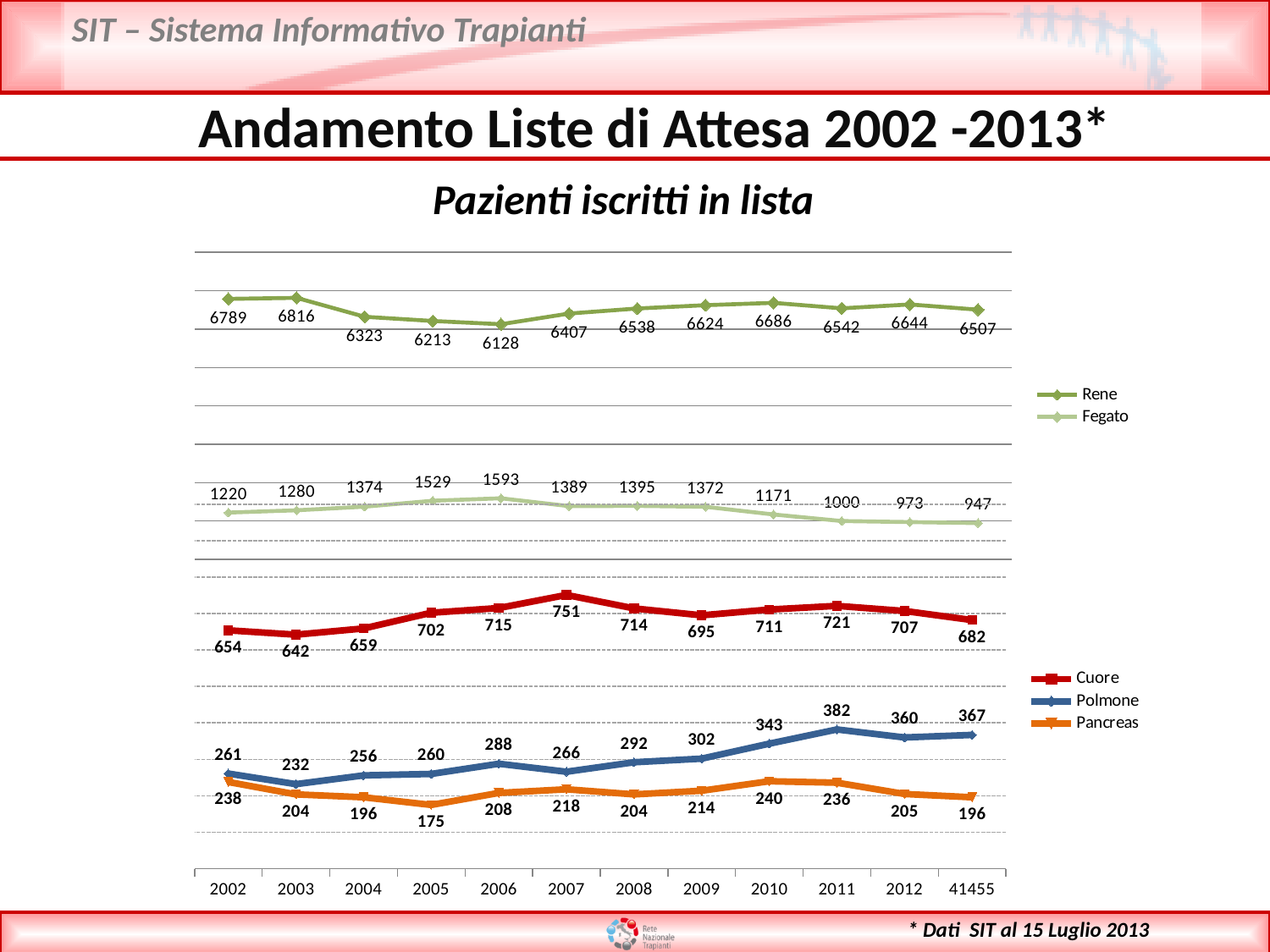
What is the value for Cuore in 2012? 707 What kind of chart is shown on the slide? line chart What is the title of the chart? Pazienti iscritti in lista What is the difference between the Polmone value in 2011 and in 2002? 121 How many series does the legend list? 5 How many data points does the Rene series have? 12 In which year does the Fegato series reach its highest value? 2006 In which year does the Pancreas series have its lowest value? 2005 Does the Fegato series rise or fall from 2006 to 2012? fall Which is larger for Cuore: the value in 2007 or the value in 2011? 2007 What is the value for Rene in 2006? 6128 What is the value for Fegato in 2010? 1171